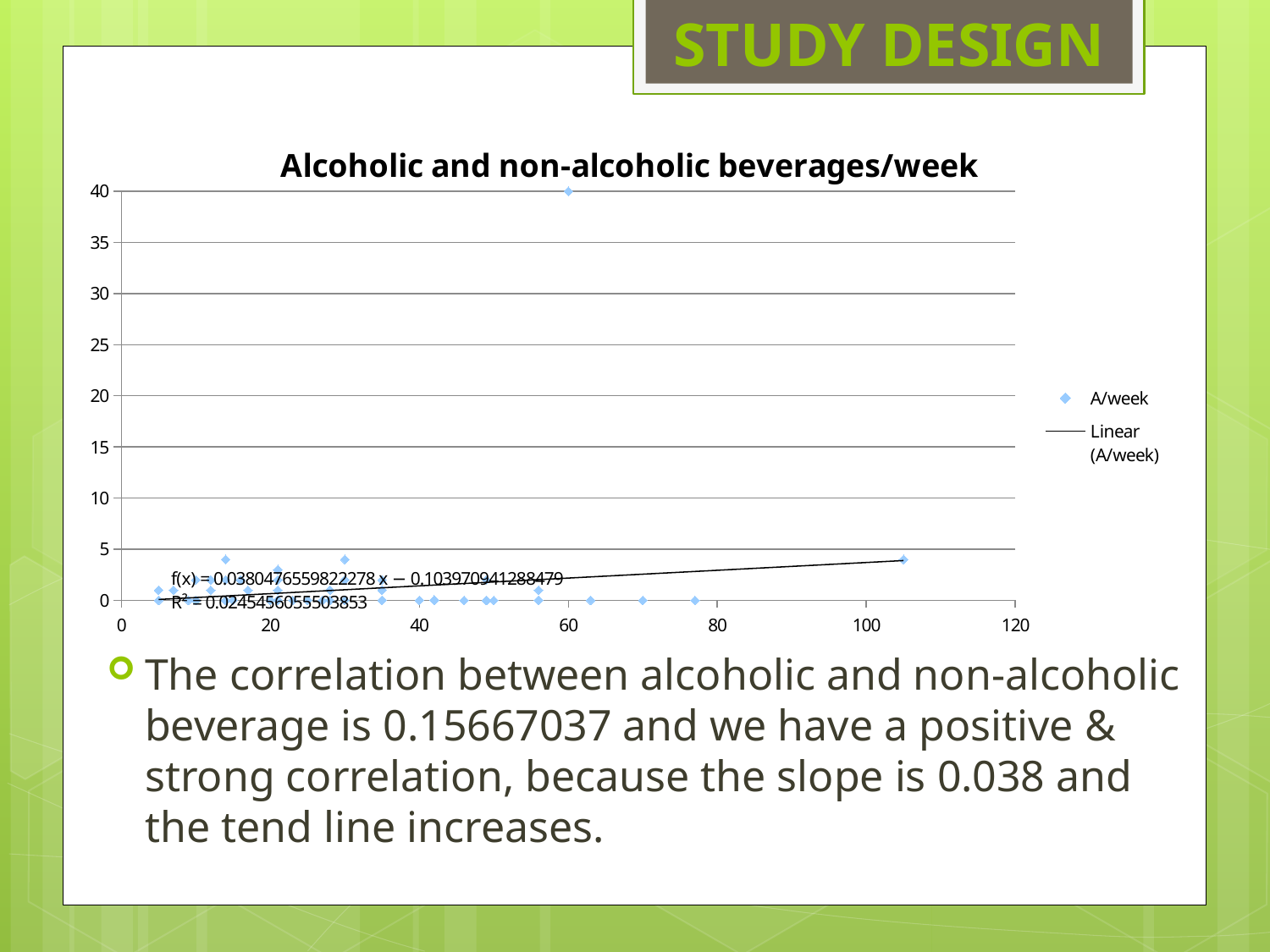
Is the y value of the data point near x = 105 greater or less than 5? less Is the y value of the highest data point greater or less than 35? greater What is the trendline equation printed on the chart? f(x) = 0.0380476559822278 x − 0.103970941288479 What R² value is printed on the chart? R² = 0.0245456055503853 Is the trendline's value at x = 100 greater or less than 5? less What kind of chart is shown on the slide? Scatter chart How many entries does the chart legend list? 2 What are the two entries in the chart legend? A/week and Linear (A/week) What is the title of the chart? Alcoholic and non-alcoholic beverages/week Does the linear trendline rise or fall as x increases? Rises